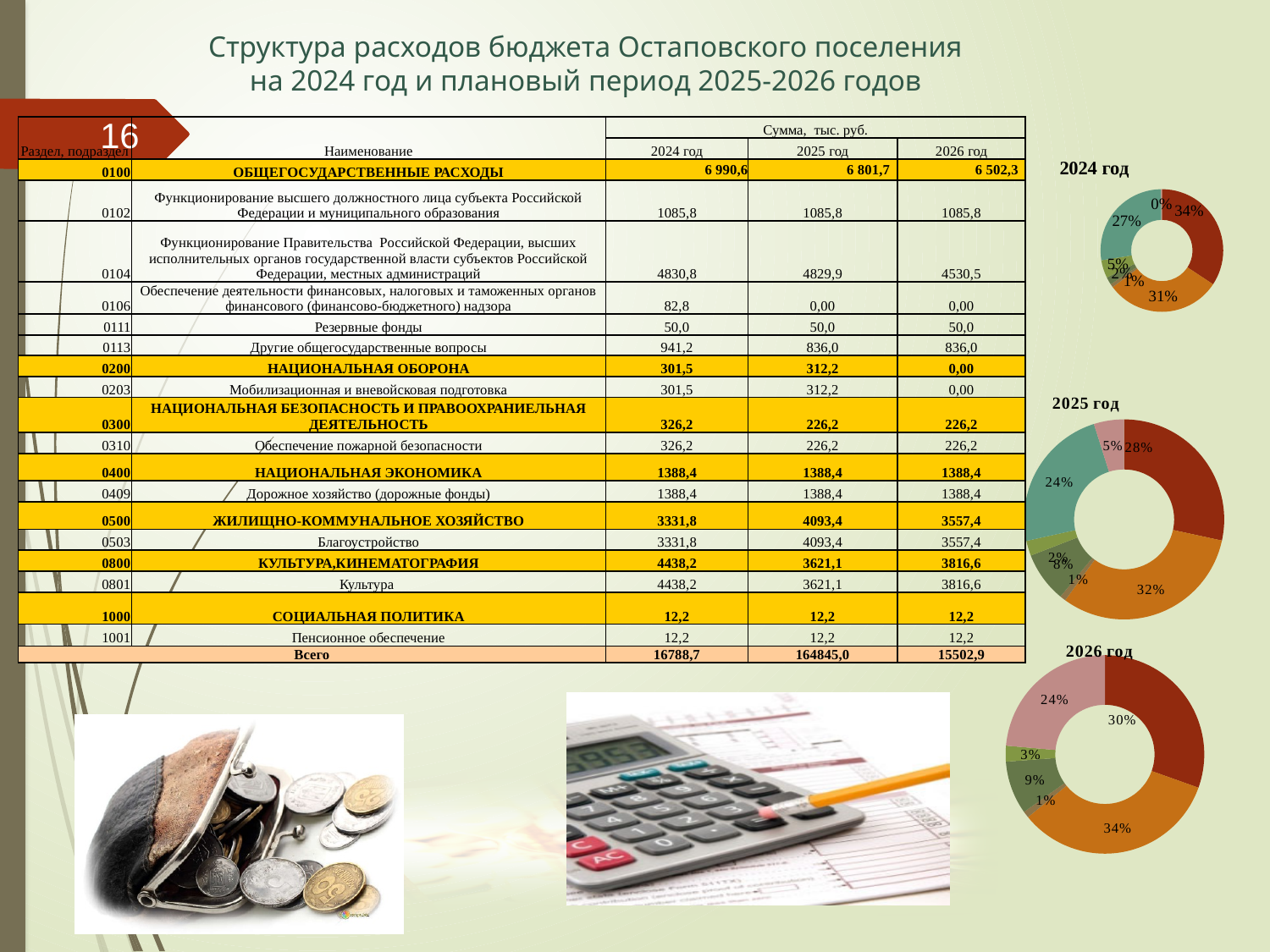
What kind of chart is used for the three charts on the right side of the slide? Doughnut (pie) chart In the chart titled "2026 год", how many slices have a percentage label? 6 In the chart titled "2026 год", what is the share of the smallest labelled slice? 1% In the chart titled "2026 год", what is the share of the largest slice? 34% In the chart titled "2025 год", what is the share of the smallest labelled slice? 1% How many charts are shown on the slide? 3 In the chart titled "2026 год", what is the difference in percentage points between the largest slice (34%) and the second largest slice (30%)? 4 percentage points Do the doughnut charts on the slide include a legend naming the slices? No What are the titles of the three charts on the slide? 2024 год, 2025 год, 2026 год In the chart titled "2024 год", what is the share of the largest slice? 34% In the chart titled "2025 год", what is the share of the largest slice? 32% Which chart has the larger biggest slice: "2025 год" (32%) or "2026 год" (34%)? 2026 год